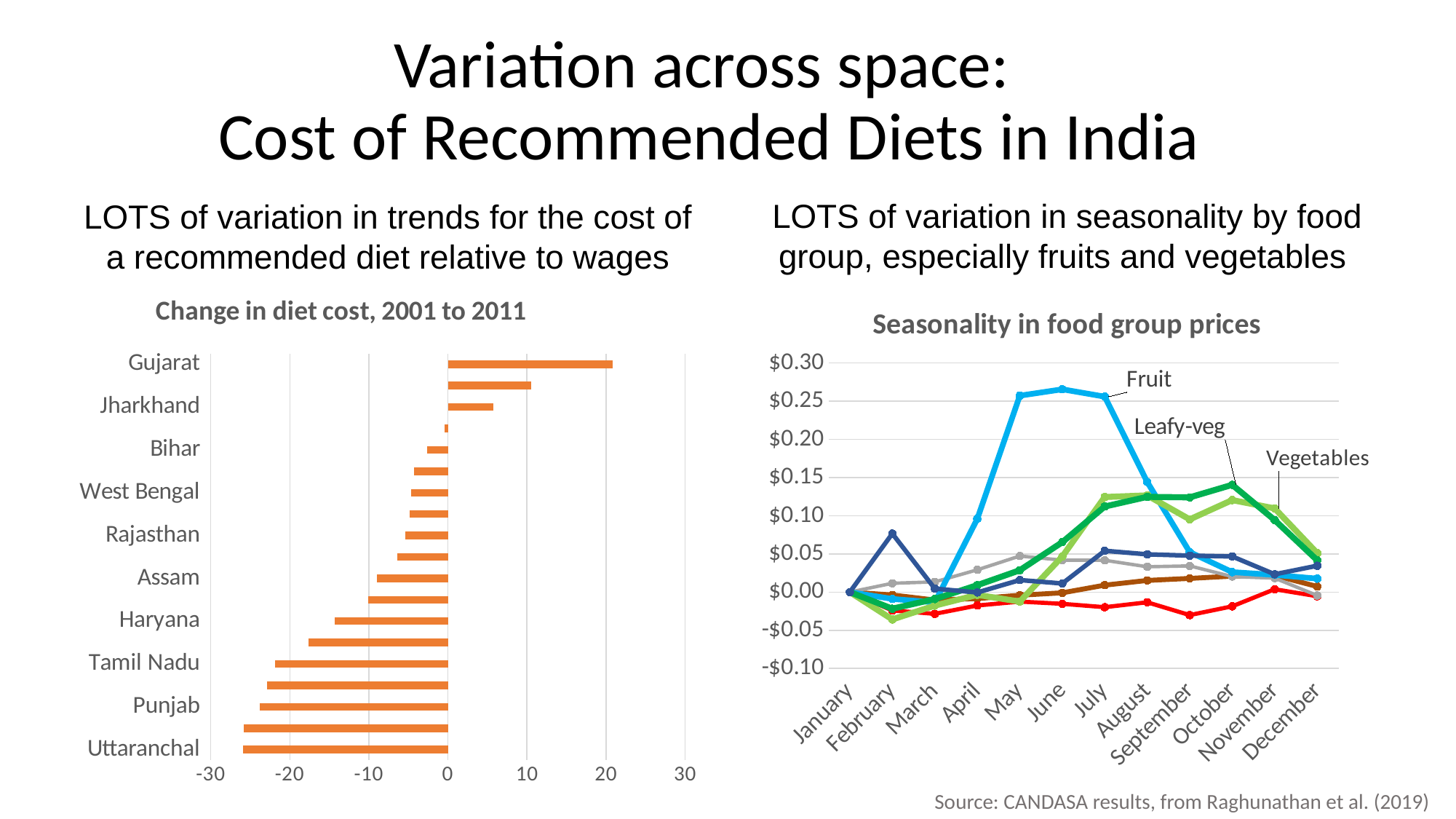
In the 'Seasonality in food group prices' chart, in which month does the Fruit line reach its highest value? June What kind of chart is the 'Seasonality in food group prices' chart on the right? line chart In the 'Change in diet cost, 2001 to 2011' chart, is the value for Uttaranchal greater or less than -20? less In the 'Change in diet cost, 2001 to 2011' chart, which is larger, the value for Gujarat or the value for Jharkhand? Gujarat In the 'Seasonality in food group prices' chart, is the Vegetables value in October greater or less than $0.10? greater In the 'Change in diet cost, 2001 to 2011' chart, is the value for Haryana greater or less than -10? less In the 'Change in diet cost, 2001 to 2011' chart, which labelled state has the highest value? Gujarat How many months are shown on the x axis of the 'Seasonality in food group prices' chart? 12 In the 'Change in diet cost, 2001 to 2011' chart, which labelled state has the lowest value? Uttaranchal What kind of chart is the 'Change in diet cost, 2001 to 2011' chart on the left? bar chart